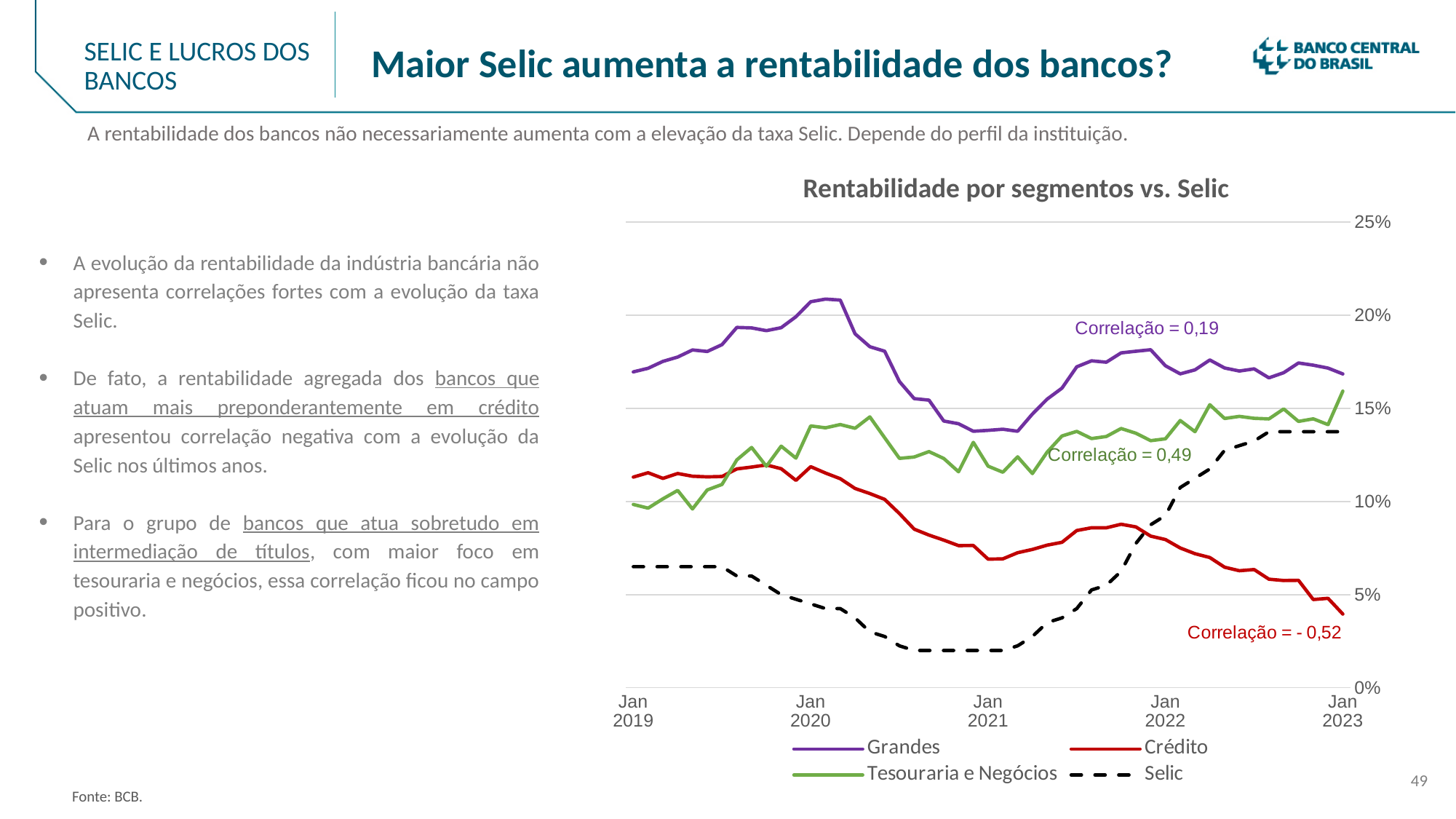
What is the title of the chart? Rentabilidade por segmentos vs. Selic What correlation value is annotated for the Crédito series? - 0,52 Which series reaches the highest value anywhere on the chart? Grandes Does the Crédito series rise or fall between Jan 2022 and Jan 2023? fall Is the value for Crédito at Jan 2023 greater or less than 5%? less What kind of chart is shown on the slide? line chart Does the Selic series rise or fall between Jan 2021 and Jan 2022? rise Is the value for Selic at Jan 2021 greater or less than 5%? less Is the value for Selic at Jan 2023 greater or less than 10%? greater At Jan 2023, which series has the larger value, Grandes or Crédito? Grandes How many series does the chart legend list? 4